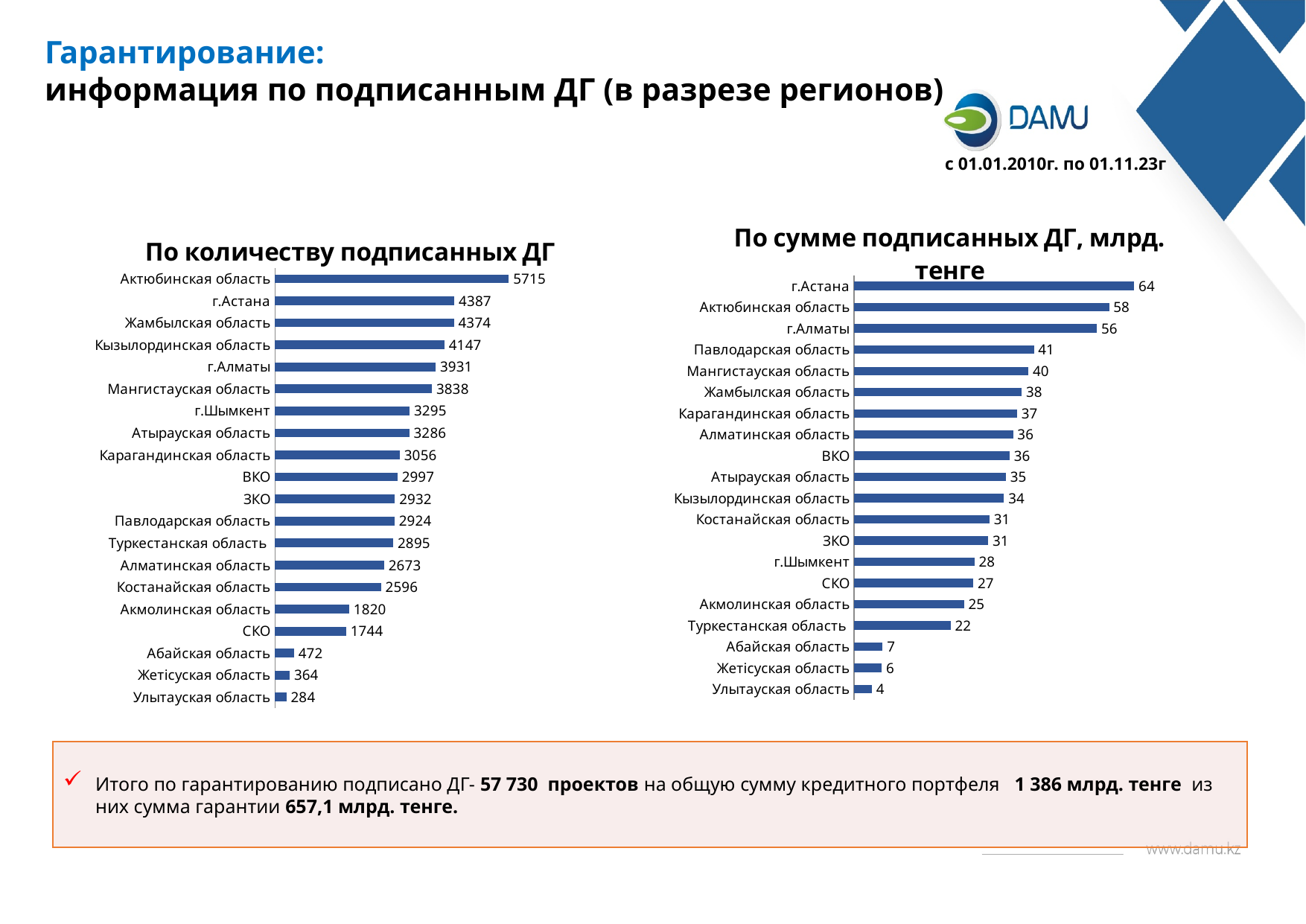
In the chart 'По сумме подписанных ДГ, млрд. тенге', which region has the highest value? г.Астана How many regions are shown in the chart 'По количеству подписанных ДГ'? 20 In the chart 'По количеству подписанных ДГ', what is the value for СКО? 1744 In the chart 'По количеству подписанных ДГ', which is larger: г.Шымкент or Атырауская область? г.Шымкент What type of chart is 'По сумме подписанных ДГ, млрд. тенге'? Bar chart In the chart 'По количеству подписанных ДГ', which region has the highest value? Актюбинская область In the chart 'По сумме подписанных ДГ, млрд. тенге', what is the difference between г.Астана and г.Алматы? 8 In the chart 'По сумме подписанных ДГ, млрд. тенге', which region has the lowest value? Улытауская область In the chart 'По сумме подписанных ДГ, млрд. тенге', what is the value for Павлодарская область? 41 In the chart 'По количеству подписанных ДГ', what is the difference between Актюбинская область and г.Астана? 1328 In the chart 'По количеству подписанных ДГ', what is the value for Кызылординская область? 4147 In the chart 'По сумме подписанных ДГ, млрд. тенге', which is larger: Туркестанская область or Акмолинская область? Акмолинская область